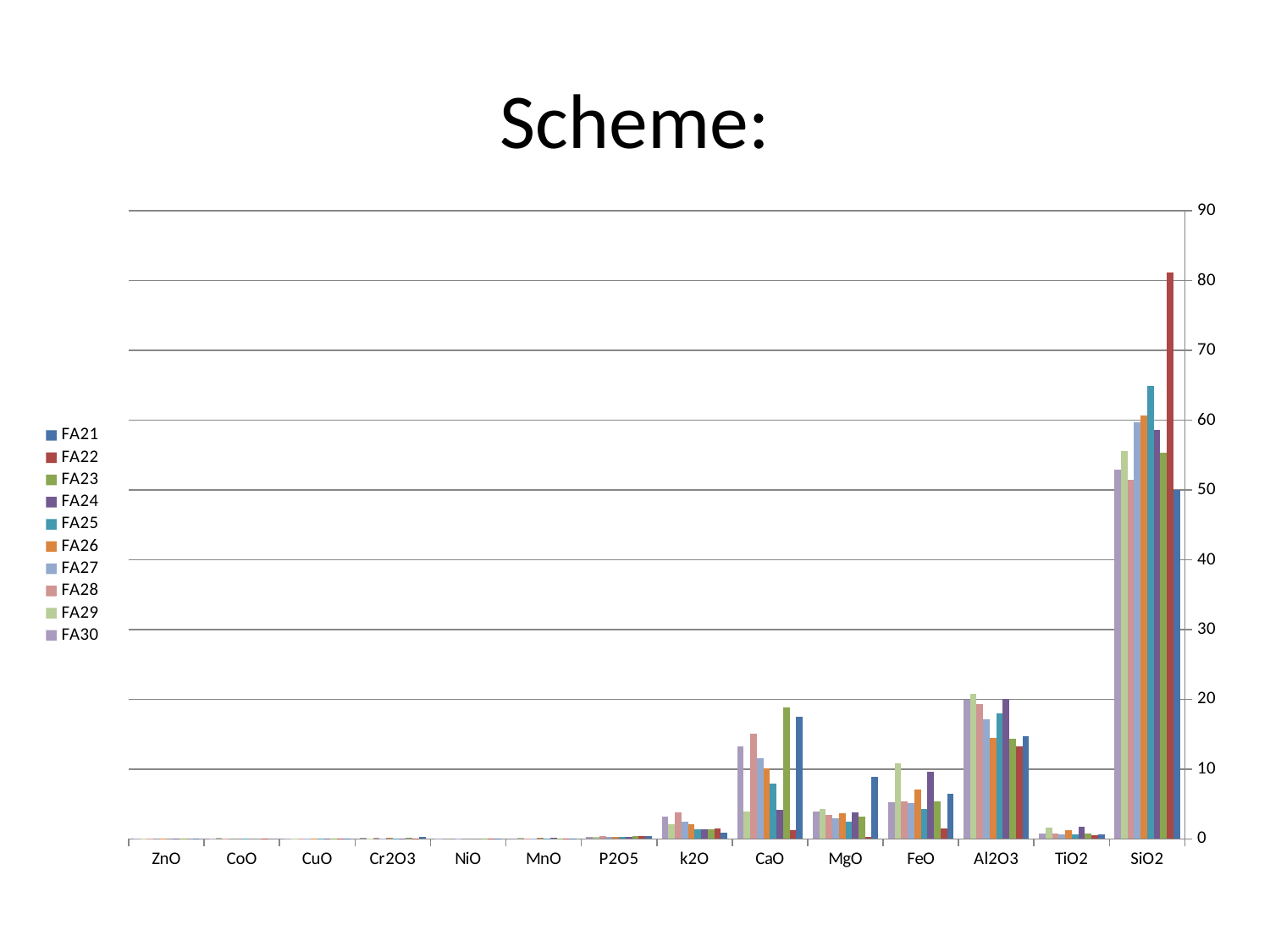
What is the title of the slide? Scheme: Which category has the highest values overall? SiO2 Is the value of FA25 for SiO2 greater or less than 60? greater Which series has the highest bar for SiO2? FA22 How many series does the legend list? 10 Is the value of FA21 for SiO2 greater or less than 60? less Which is larger for Al2O3, FA29 or FA26? FA29 Is the value of FA22 for SiO2 greater or less than 70? greater What kind of chart is shown on the slide? bar chart Which is larger for CaO, FA23 or FA24? FA23 How many categories are shown along the x axis? 14